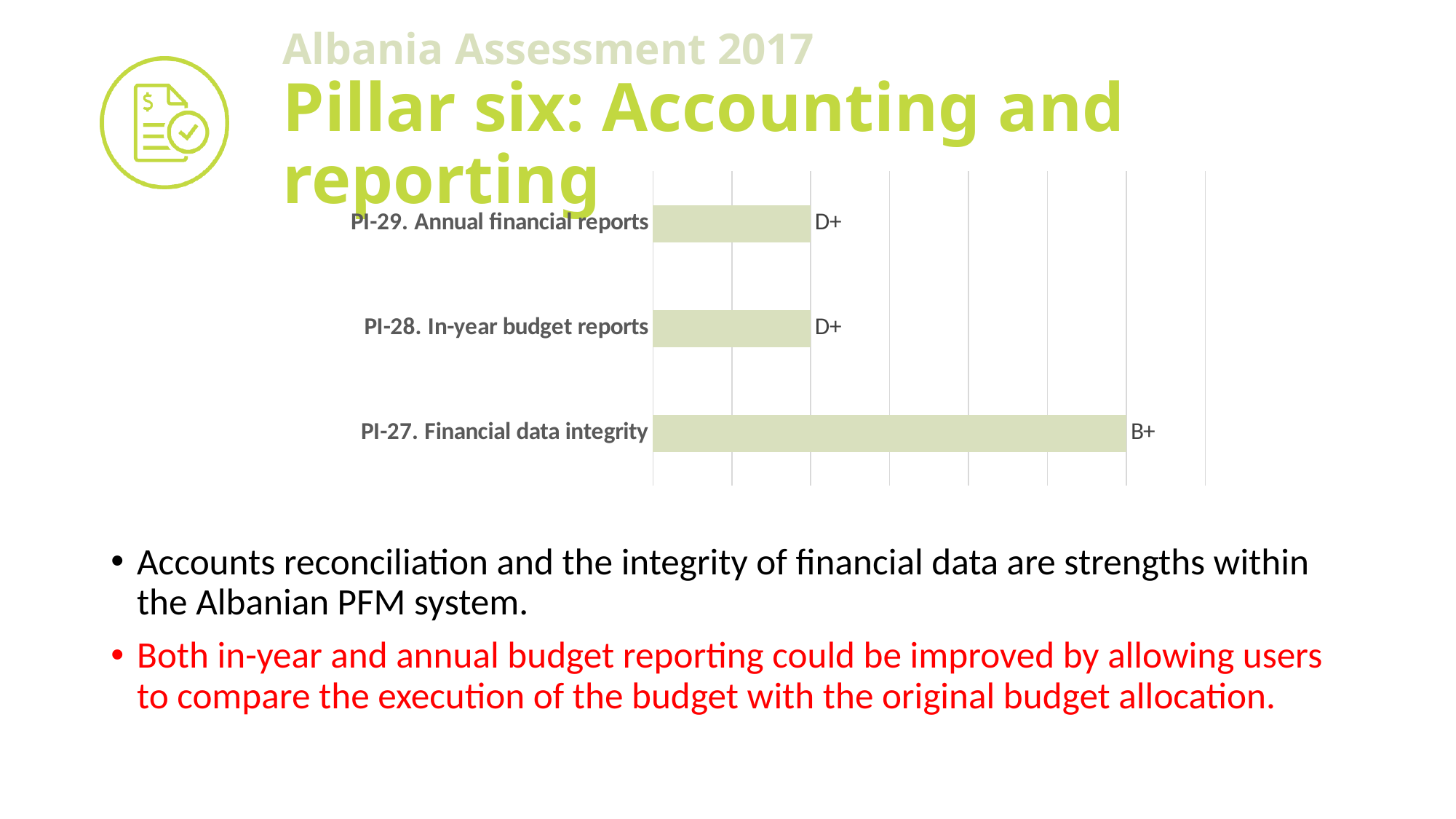
Which has the longer bar, PI-29. Annual financial reports or PI-27. Financial data integrity? PI-27. Financial data integrity Which indicator has the highest score in the chart? PI-27. Financial data integrity How many indicators are plotted in the chart? 3 What score is shown for PI-28. In-year budget reports? D+ What score is shown for PI-27. Financial data integrity? B+ Which two indicators in the chart received the same score? PI-29. Annual financial reports and PI-28. In-year budget reports Which indicator has the longest bar in the chart? PI-27. Financial data integrity What score is shown for PI-29. Annual financial reports? D+ What kind of chart is shown on the slide? Bar chart Are the bars in the chart drawn horizontally or vertically? Horizontally Which has the longer bar, PI-27. Financial data integrity or PI-28. In-year budget reports? PI-27. Financial data integrity